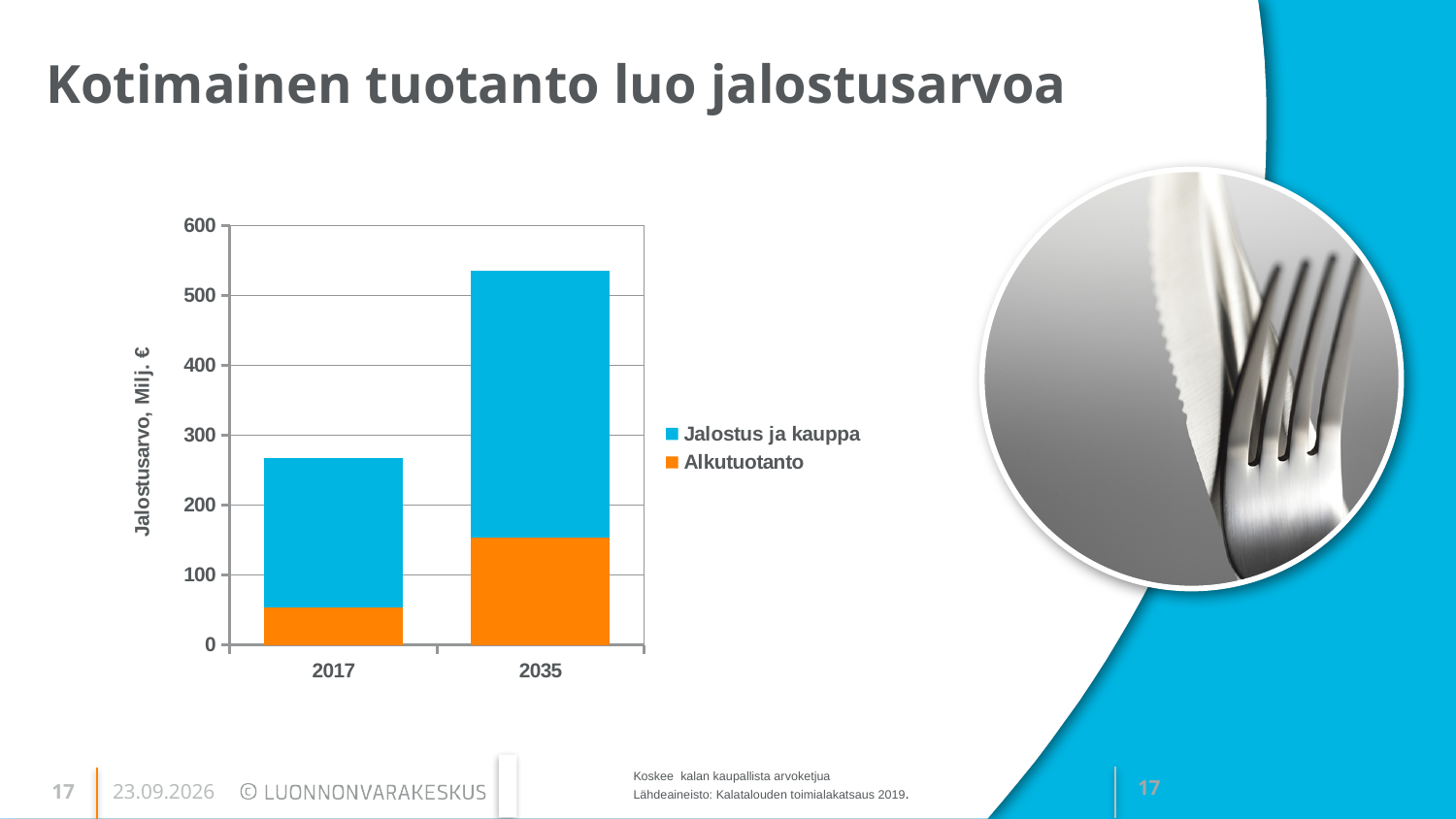
Is the total value for 2017 greater or less than 300? less How many years (categories) are shown on the x axis of the chart? 2 Which year has the higher total bar in the chart? 2035 What is the label on the vertical axis of the chart? Jalostusarvo, Milj. € Is the Alkutuotanto value for 2017 greater or less than 100? less Which year has the lower total bar in the chart? 2017 Is the total value for 2035 greater or less than 500? greater How many series does the chart legend list? 2 What kind of chart is shown on the slide? Stacked bar chart Do the total bar values rise or fall from 2017 to 2035? rise Which year has the larger Alkutuotanto segment, 2017 or 2035? 2035